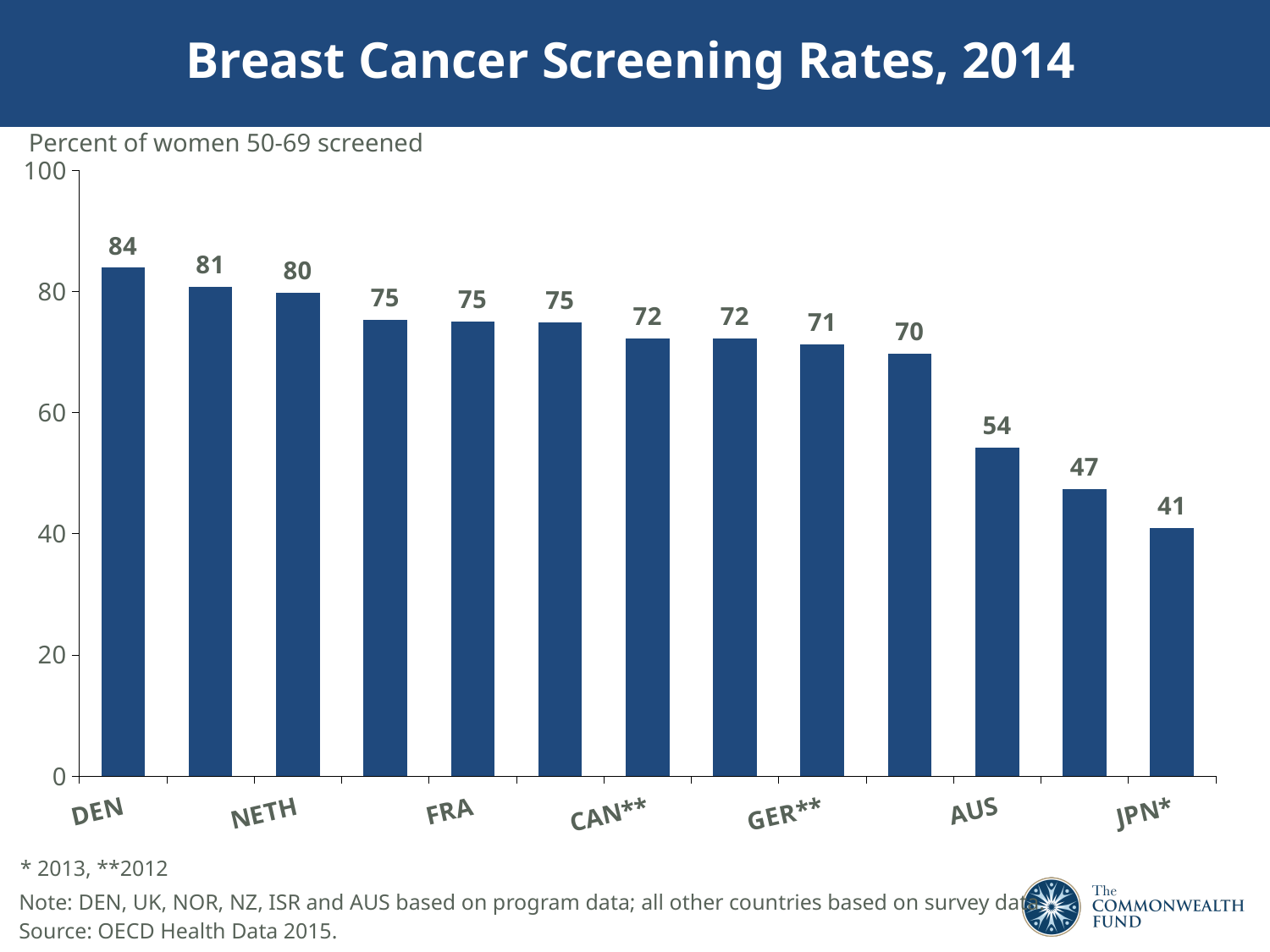
What is the difference between the values for DEN and JPN*? 43 What is the breast cancer screening rate for DEN? 84 Which labelled country has the lowest screening rate? JPN* What is the value shown for AUS? 54 Which labelled country has the highest screening rate? DEN What is the value shown for CAN**? 72 Which has a higher value, AUS or JPN*? AUS What is the value shown for GER**? 71 How many bars are plotted in the chart? 13 What is the value shown for JPN*? 41 What is the value shown for FRA? 75 What is the value shown for NETH? 80